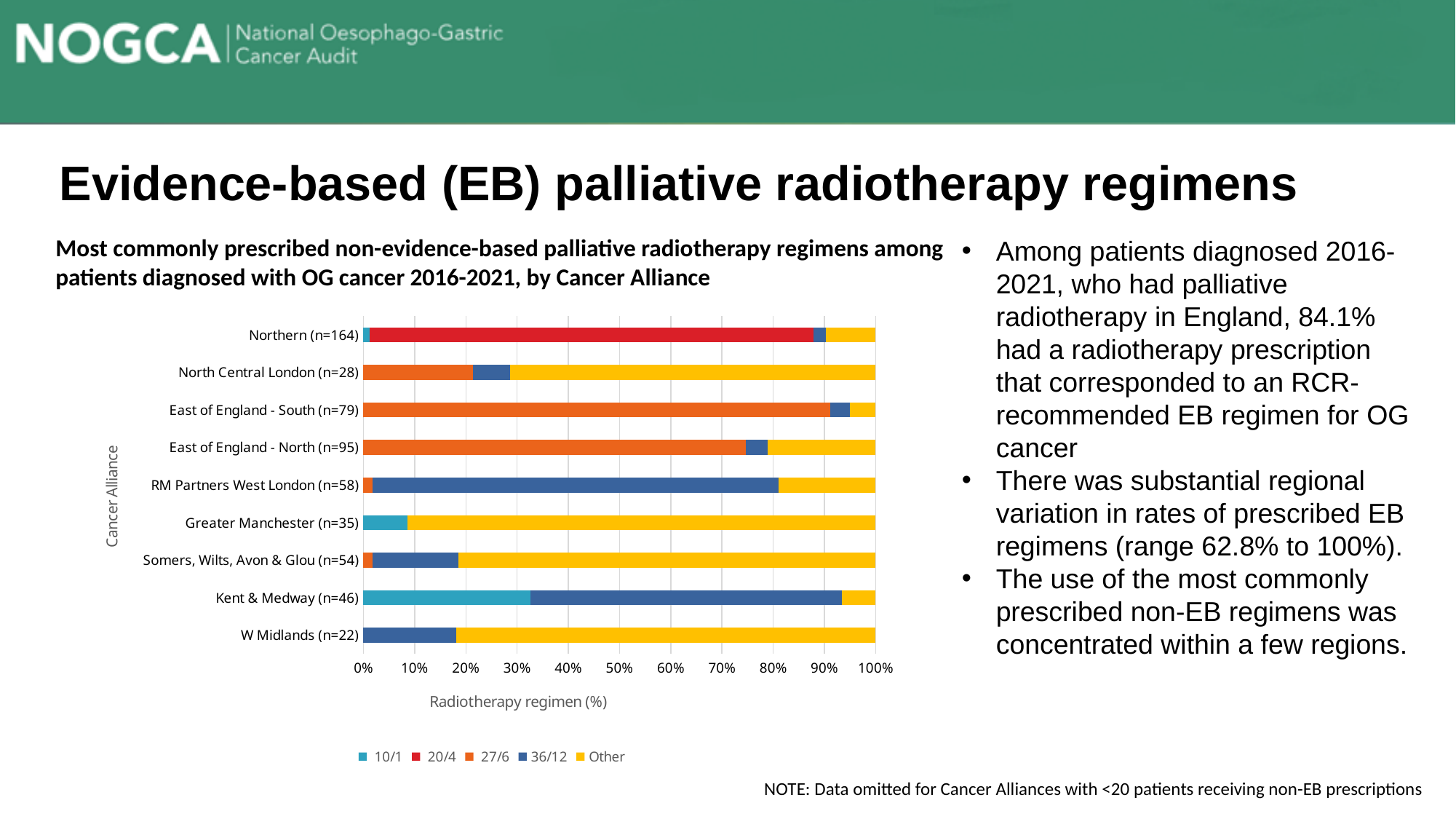
How many series does the chart legend list? 5 Which has the larger 'Other' share: Greater Manchester (n=35) or Northern (n=164)? Greater Manchester (n=35) What is the label of the horizontal axis of the chart? Radiotherapy regimen (%) Is the 36/12 share for W Midlands (n=22) greater or less than 20%? less What kind of chart is shown on the slide? Stacked bar chart Is the 10/1 share for Kent & Medway (n=46) greater or less than 30%? greater How many Cancer Alliances are plotted on the chart? 9 Which Cancer Alliance has the largest 27/6 share on the chart? East of England - South (n=79) Is the 20/4 share for Northern (n=164) greater or less than 80%? greater Which Cancer Alliance has the largest 36/12 share on the chart? RM Partners West London (n=58) Which Cancer Alliance has the largest 'Other' share on the chart? Greater Manchester (n=35)